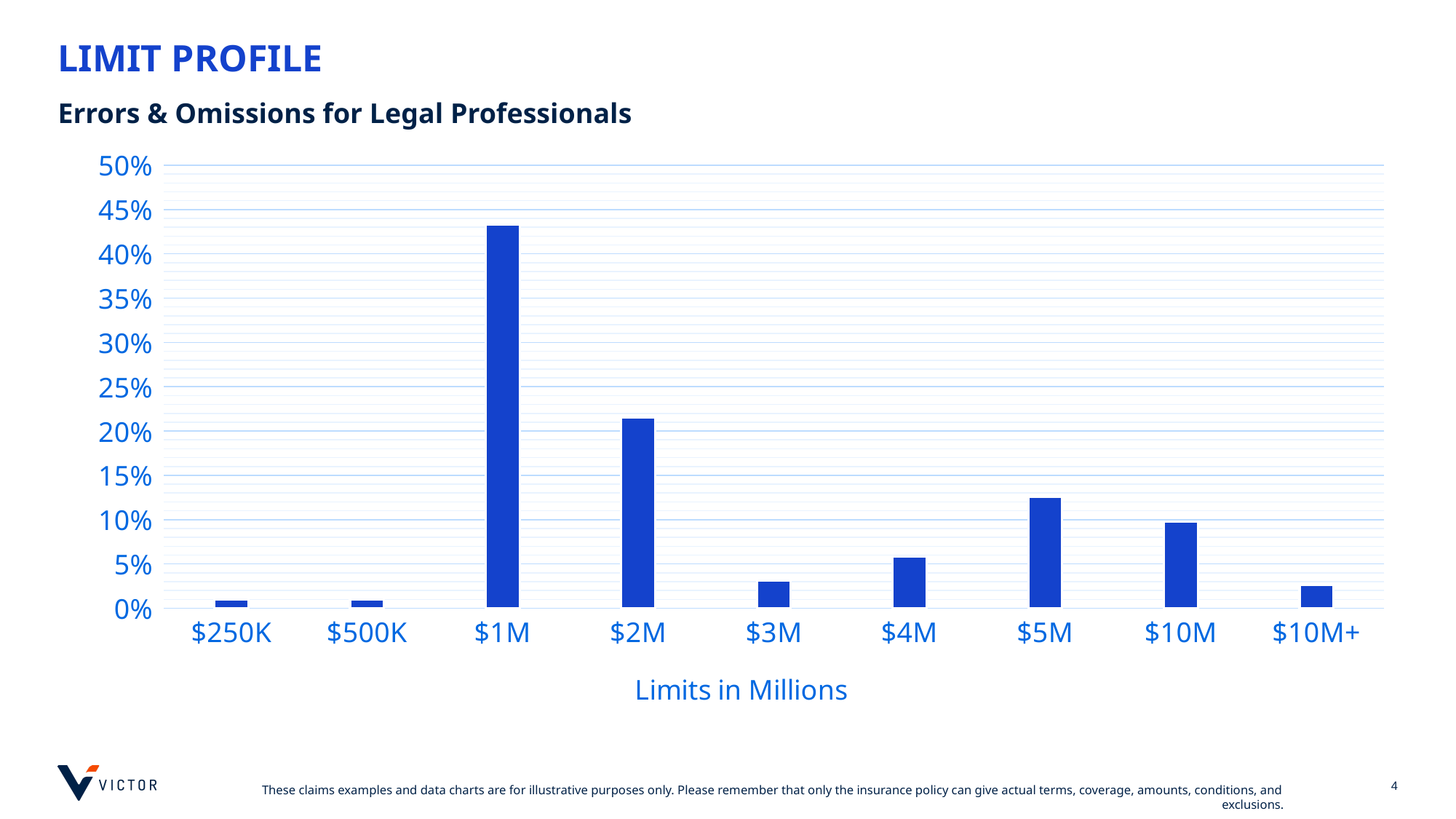
Is the value for $4M greater or less than 5%? greater Is the value for $5M greater or less than 10%? greater Which has a higher percentage, $5M or $10M? $5M What is the title of the x axis? Limits in Millions Is the value for $2M greater or less than 20%? greater What kind of chart is shown on the slide? bar chart Which limit category has the highest percentage? $1M Which has a higher percentage, $2M or $5M? $2M How many limit categories are shown on the x axis? 9